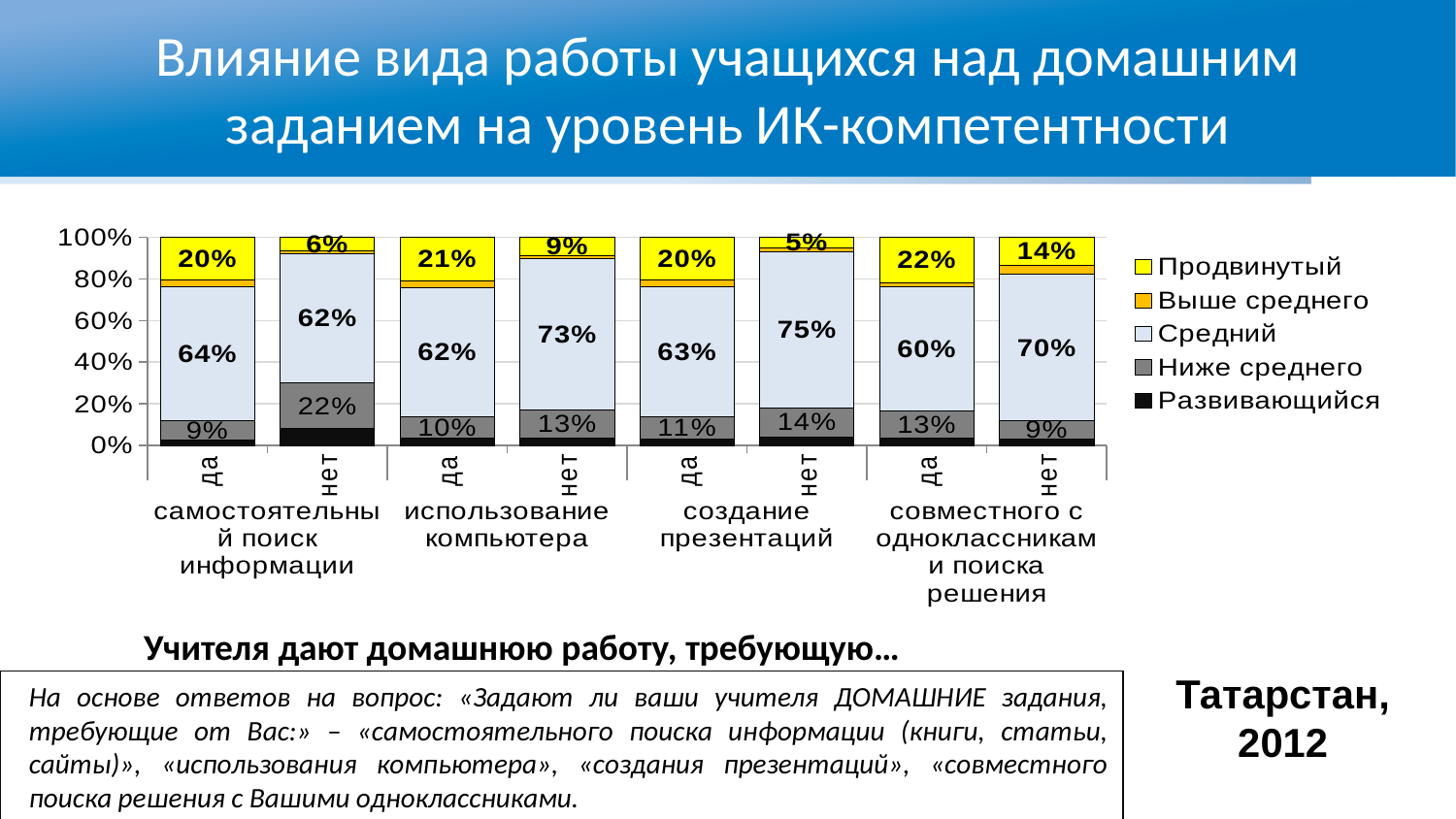
Which is larger: the Средний value for 'да' or for 'нет' under 'использование компьютера'? нет How many series does the legend list? 5 What is the value of the Ниже среднего segment for the 'нет' bar under 'самостоятельный поиск информации'? 22% How many bars are plotted in the chart? 8 Which legend entry is shown in yellow? Продвинутый What is the value of the Средний segment for the 'нет' bar under 'создание презентаций'? 75% What is the difference between the Продвинутый values for 'да' and 'нет' under 'совместного с одноклассниками и поиска решения'? 8% Which bar has the lowest Продвинутый value? нет, создание презентаций What kind of chart is shown on the slide? stacked bar chart Which bar has the highest Продвинутый value? да, совместного с одноклассниками и поиска решения What is the value of the Продвинутый segment for the 'нет' bar under 'использование компьютера'? 9% What is the value of the Средний segment for the 'да' bar under 'самостоятельный поиск информации'? 64%